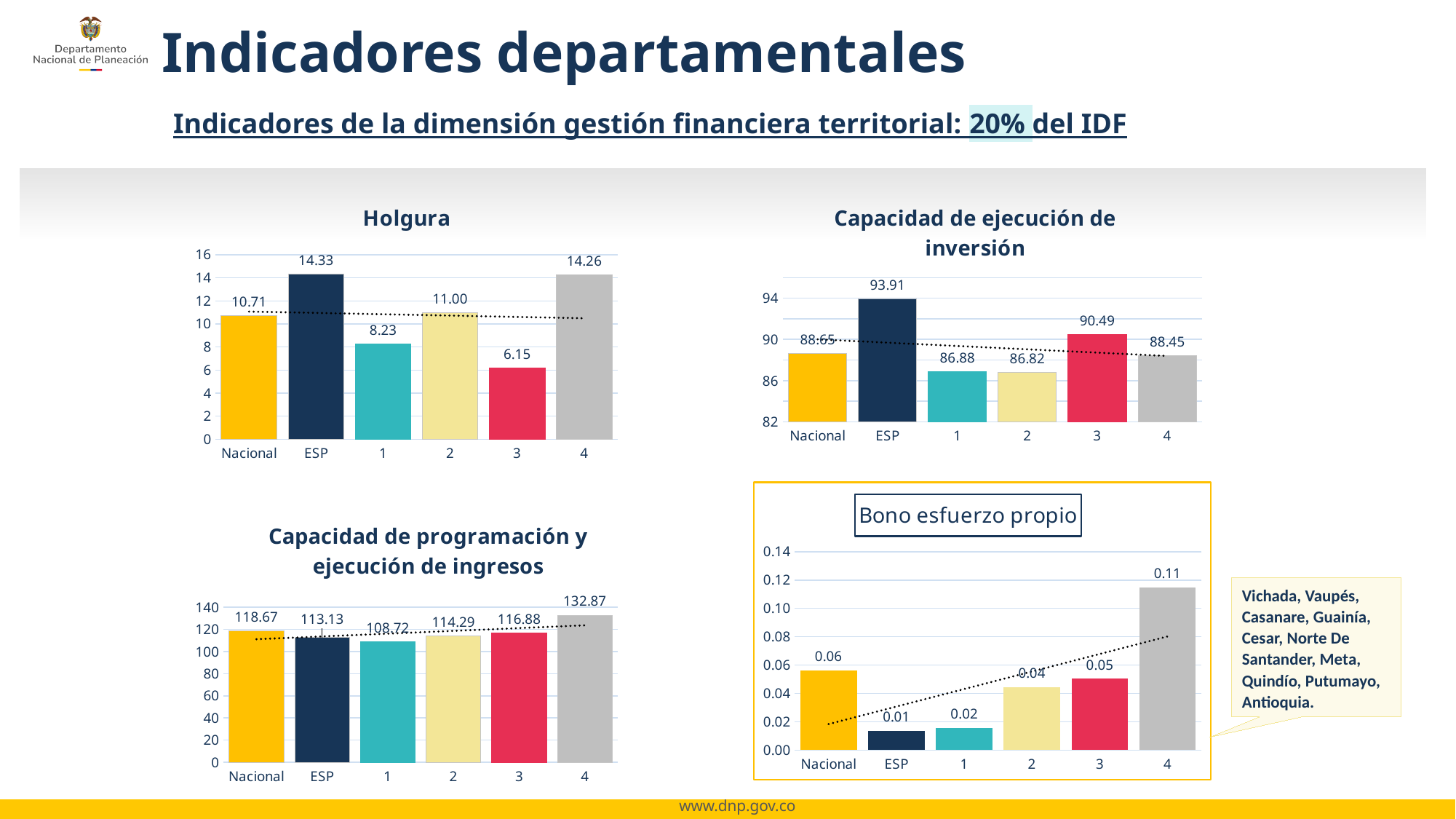
In the Holgura chart, which category has the lowest value? 3 In the Capacidad de programación y ejecución de ingresos chart, what is the value for category 4? 132.87 In the Holgura chart, what is the difference between the values for Nacional and 3? 4.56 In the Capacidad de ejecución de inversión chart, is the value for Nacional greater or less than 86? greater In the Bono esfuerzo propio chart, what is the difference between the values for category 4 and Nacional? 0.05 In the Holgura chart, what is the value for ESP? 14.33 In the Capacidad de ejecución de inversión chart, what is the value for category 3? 90.49 In the Bono esfuerzo propio chart, what is the value for category 4? 0.11 In the Capacidad de programación y ejecución de ingresos chart, which category has the lowest value? 1 In the Capacidad de programación y ejecución de ingresos chart, which is larger, the value for Nacional or the value for ESP? Nacional In the Capacidad de ejecución de inversión chart, which category has the highest value? ESP How many categories are shown on the x axis of the Bono esfuerzo propio chart? 6